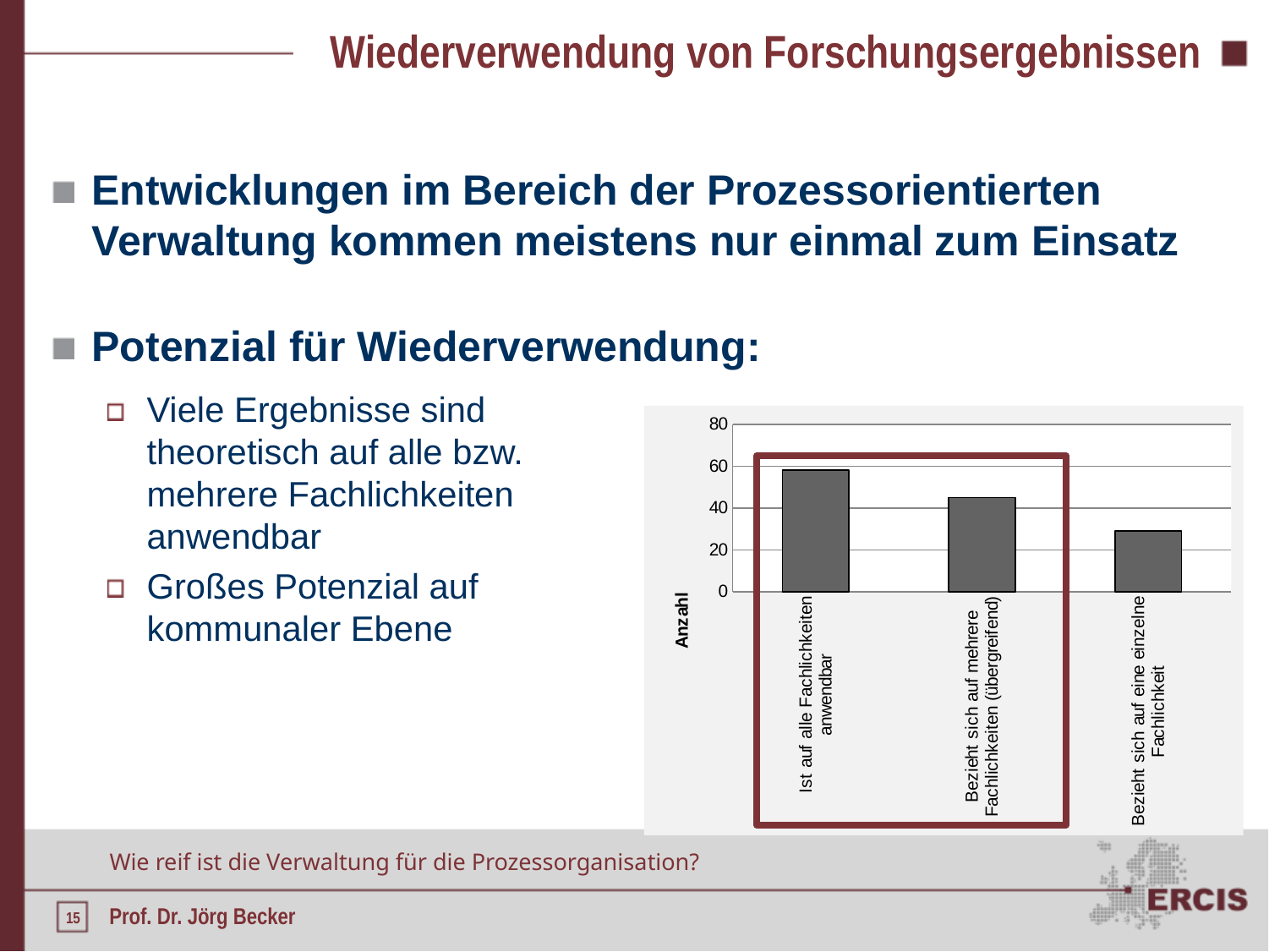
Is the value for 'Bezieht sich auf mehrere Fachlichkeiten (übergreifend)' greater or less than 60? less Is the value for 'Bezieht sich auf eine einzelne Fachlichkeit' greater or less than 40? less Which category has the highest value in the chart? Ist auf alle Fachlichkeiten anwendbar What is the label of the vertical axis of the chart? Anzahl How many categories are plotted in the chart? 3 Do the bar values rise or fall from left to right across the chart? fall Is the value for 'Bezieht sich auf eine einzelne Fachlichkeit' greater or less than 20? greater Which is larger: the value for 'Bezieht sich auf mehrere Fachlichkeiten (übergreifend)' or the value for 'Bezieht sich auf eine einzelne Fachlichkeit'? Bezieht sich auf mehrere Fachlichkeiten (übergreifend) What kind of chart is shown on the slide? bar chart Which category has the lowest value in the chart? Bezieht sich auf eine einzelne Fachlichkeit Which is larger: the value for 'Ist auf alle Fachlichkeiten anwendbar' or the value for 'Bezieht sich auf eine einzelne Fachlichkeit'? Ist auf alle Fachlichkeiten anwendbar